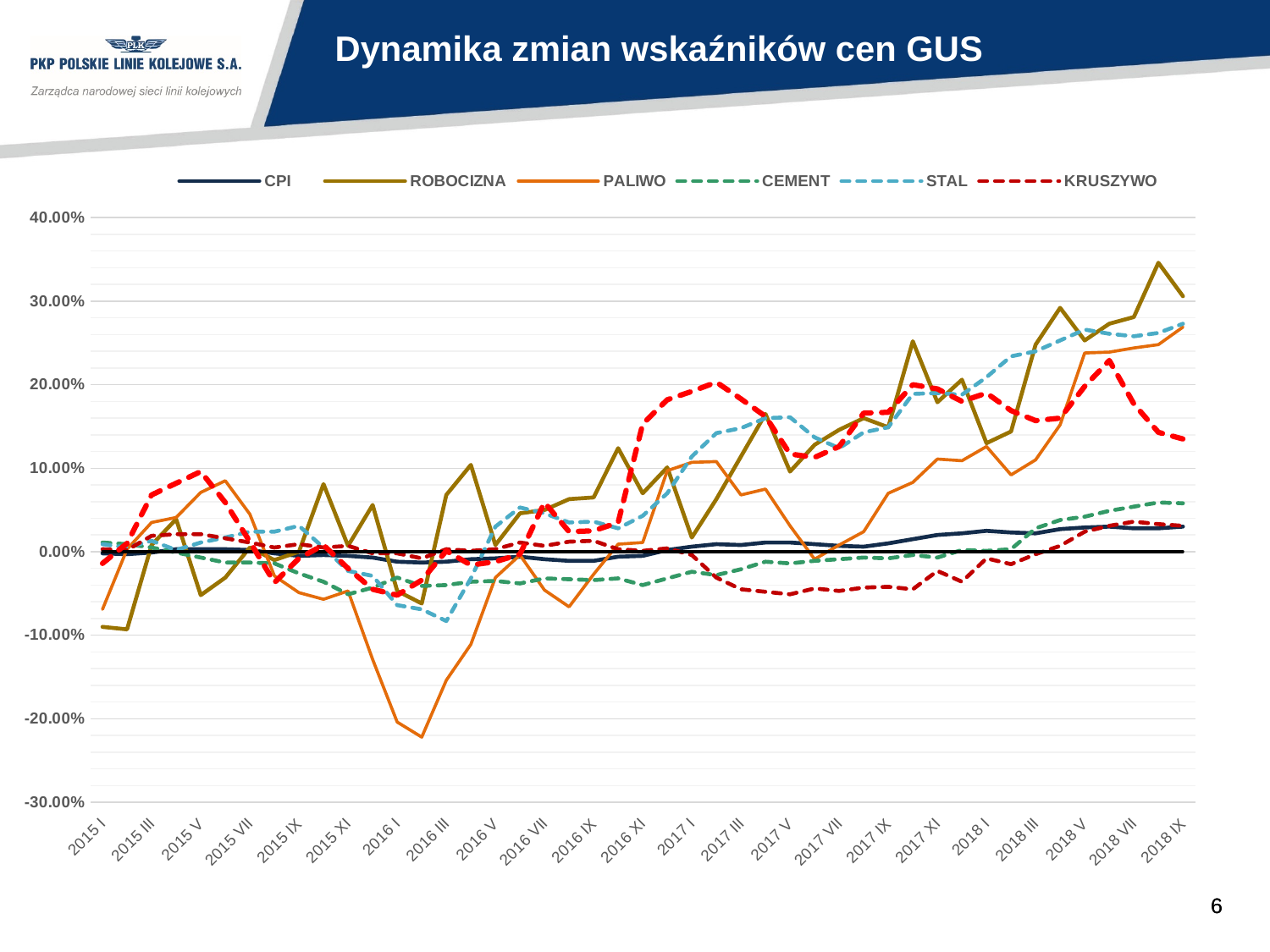
How many series does the legend list? 6 Which series reaches the highest value anywhere on the chart? ROBOCIZNA Is the value for CEMENT at 2018 IX greater or less than 0.00%? greater What is the title of the chart? Dynamika zmian wskaźników cen GUS What kind of chart is shown on the slide? line chart Does the PALIWO series rise or fall between 2015 XI and 2016 II? fall Does the STAL series rise or fall between 2017 I and 2018 IX? rise Is the value for PALIWO at 2016 II greater or less than -20.00%? less Which series reaches the lowest value anywhere on the chart? PALIWO Is the peak value for ROBOCIZNA in 2018 greater or less than 30.00%? greater At 2018 IX, which is larger: ROBOCIZNA or KRUSZYWO? ROBOCIZNA Which series is drawn as a dashed red line? KRUSZYWO